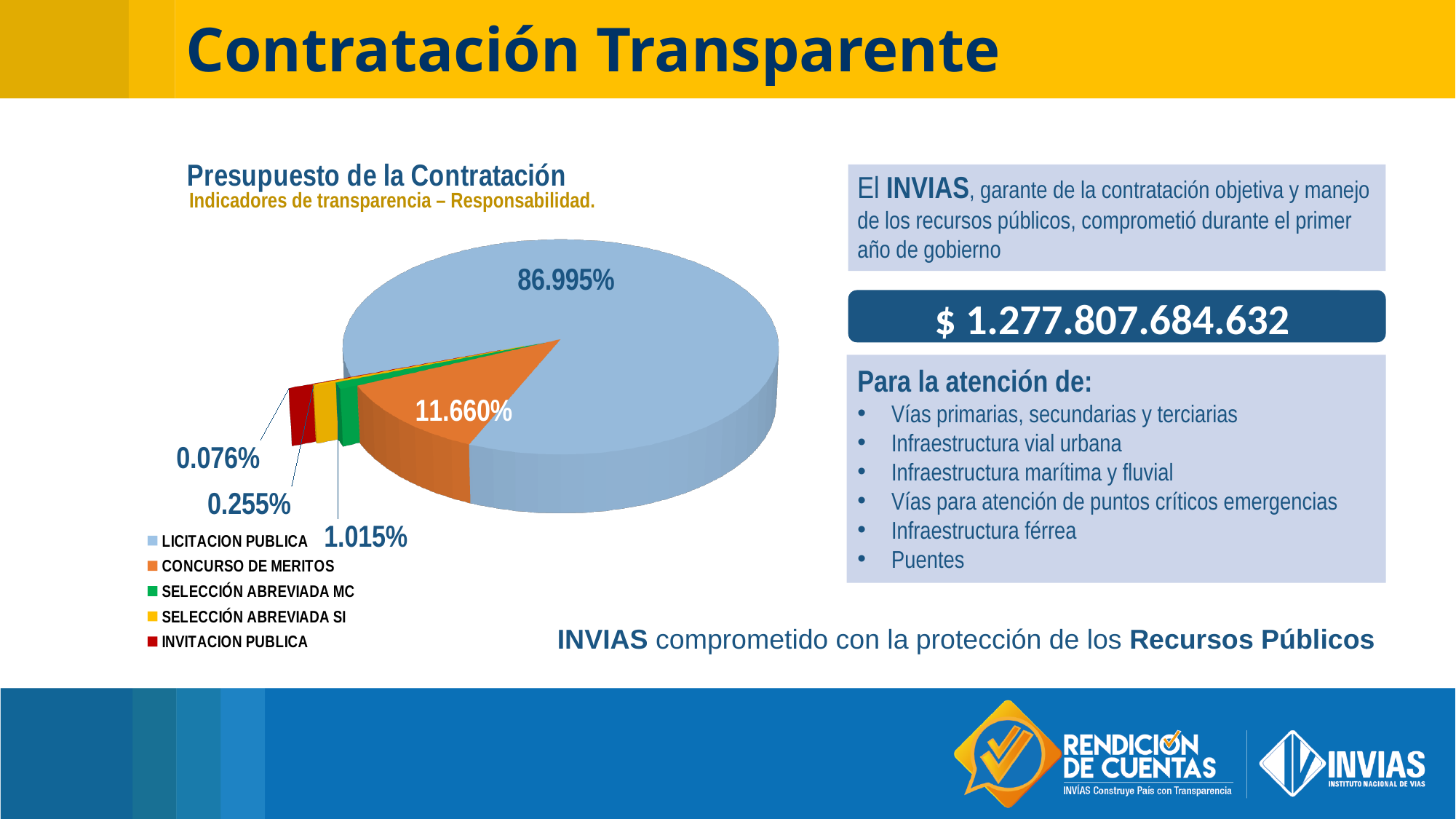
Which is larger, the share for CONCURSO DE MERITOS or the share for SELECCIÓN ABREVIADA MC? CONCURSO DE MERITOS What share of the pie does SELECCIÓN ABREVIADA SI represent? 0.255% What share of the pie does LICITACION PUBLICA represent? 86.995% What colour is the slice for SELECCIÓN ABREVIADA MC in the pie chart? Green What share of the pie does SELECCIÓN ABREVIADA MC represent? 1.015% What share of the pie does CONCURSO DE MERITOS represent? 11.660% What share of the pie does INVITACION PUBLICA represent? 0.076% What kind of chart is shown under the title "Presupuesto de la Contratación"? Pie chart Which category has the smallest slice of the pie? INVITACION PUBLICA What is the difference in percentage points between the LICITACION PUBLICA share and the CONCURSO DE MERITOS share? 75.335% How many categories does the pie chart legend list? 5 Which category has the largest slice of the pie? LICITACION PUBLICA